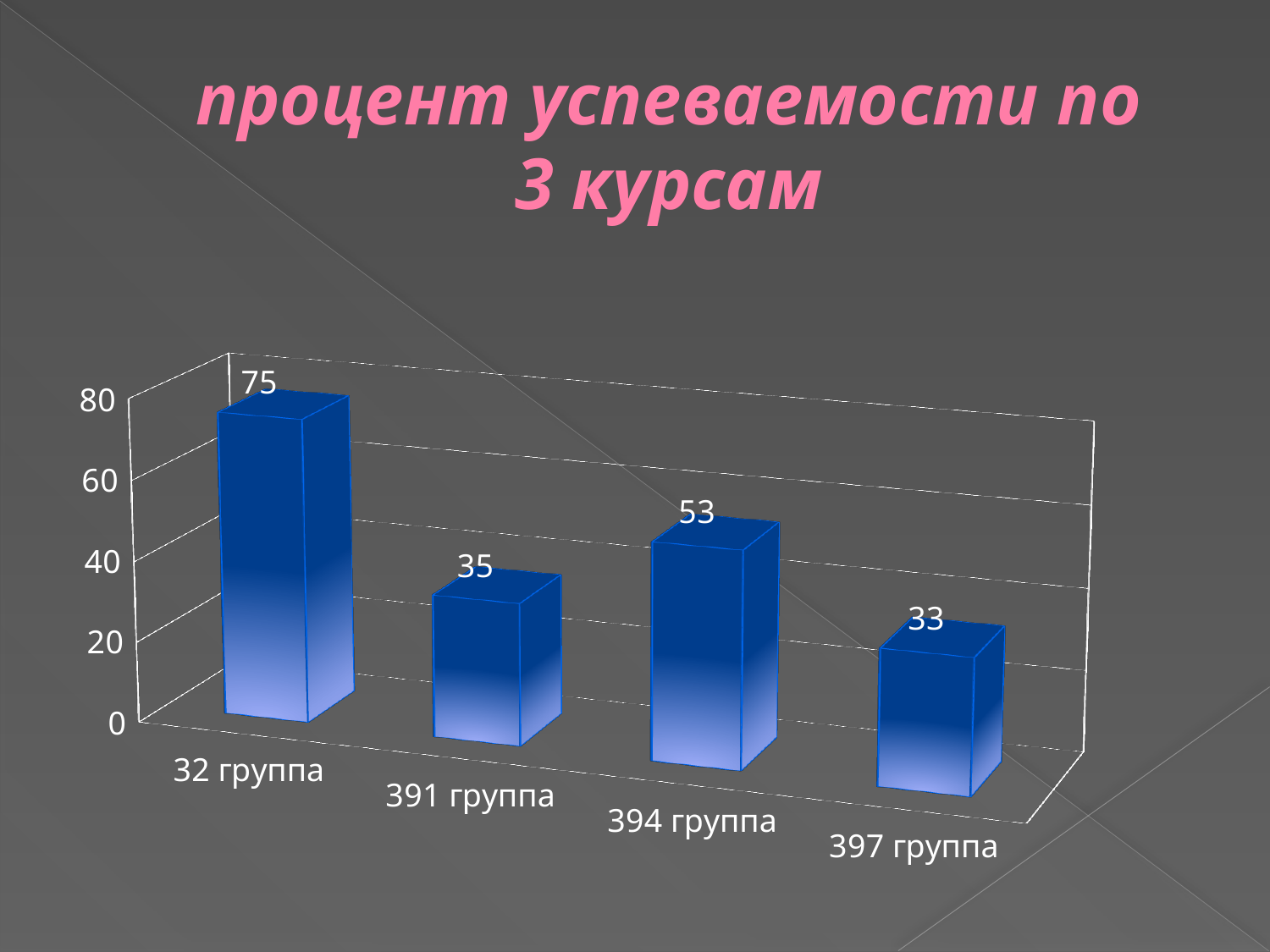
What is the value for 391 группа? 35 What is the value for 32 группа? 75 Which is larger, the value for 394 группа or the value for 391 группа? 394 группа What is the value for 394 группа? 53 How many groups are shown on the chart? 4 What is the difference between the values for 391 группа and 397 группа? 2 Which group has the highest value? 32 группа Which group has the lowest value? 397 группа What is the title of the slide? процент успеваемости по 3 курсам What kind of chart is shown on the slide? bar chart What is the value for 397 группа? 33 What is the difference between the values for 32 группа and 394 группа? 22